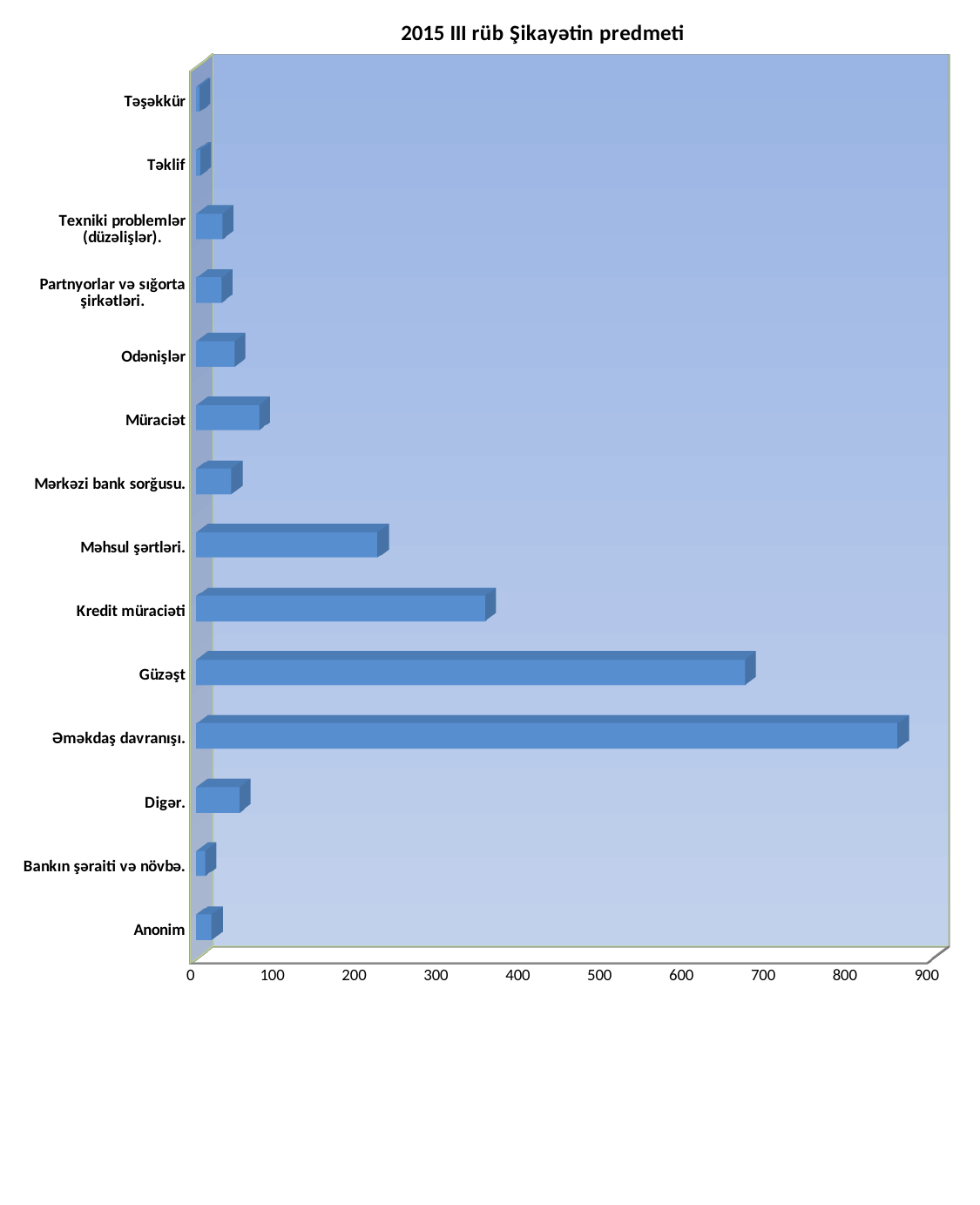
What is the title of the chart? 2015 III rüb Şikayətin predmeti Is the value for Əməkdaş davranışı. greater or less than 800? greater Which category has the highest value? Əməkdaş davranışı. What type of chart is shown on the slide? Bar chart Is the value for Kredit müraciəti greater or less than 300? greater Is the value for Məhsul şərtləri. greater or less than 300? less Which is larger, the value for Güzəşt or the value for Kredit müraciəti? Güzəşt Which is larger, the value for Məhsul şərtləri. or the value for Müraciət? Məhsul şərtləri. How many categories are shown on the chart? 14